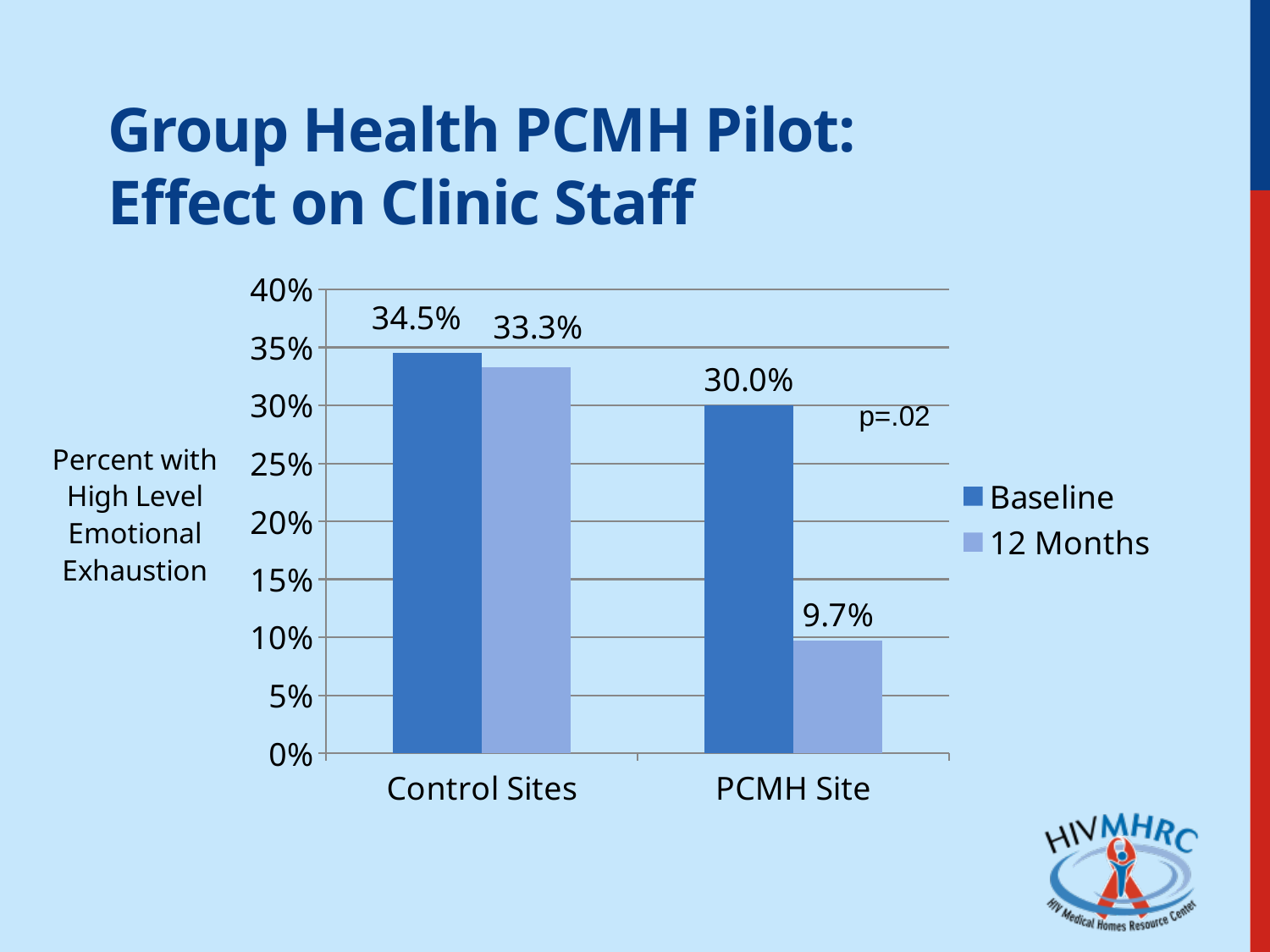
Which bar has the lowest value on the chart? PCMH Site, 12 Months What is the difference between the Baseline and 12 Months values for PCMH Site? 20.3% What p-value is printed on the chart? p=.02 What kind of chart is shown on the slide? Bar chart Which is larger: the 12 Months value for Control Sites or the 12 Months value for PCMH Site? Control Sites Which bar has the highest value on the chart? Control Sites, Baseline What is the difference between the Baseline values for Control Sites and PCMH Site? 4.5% How many series does the legend list? 2 What is the Baseline value for PCMH Site? 30.0% What is the 12 Months value for PCMH Site? 9.7% What is the 12 Months value for Control Sites? 33.3% What is the Baseline value for Control Sites? 34.5%